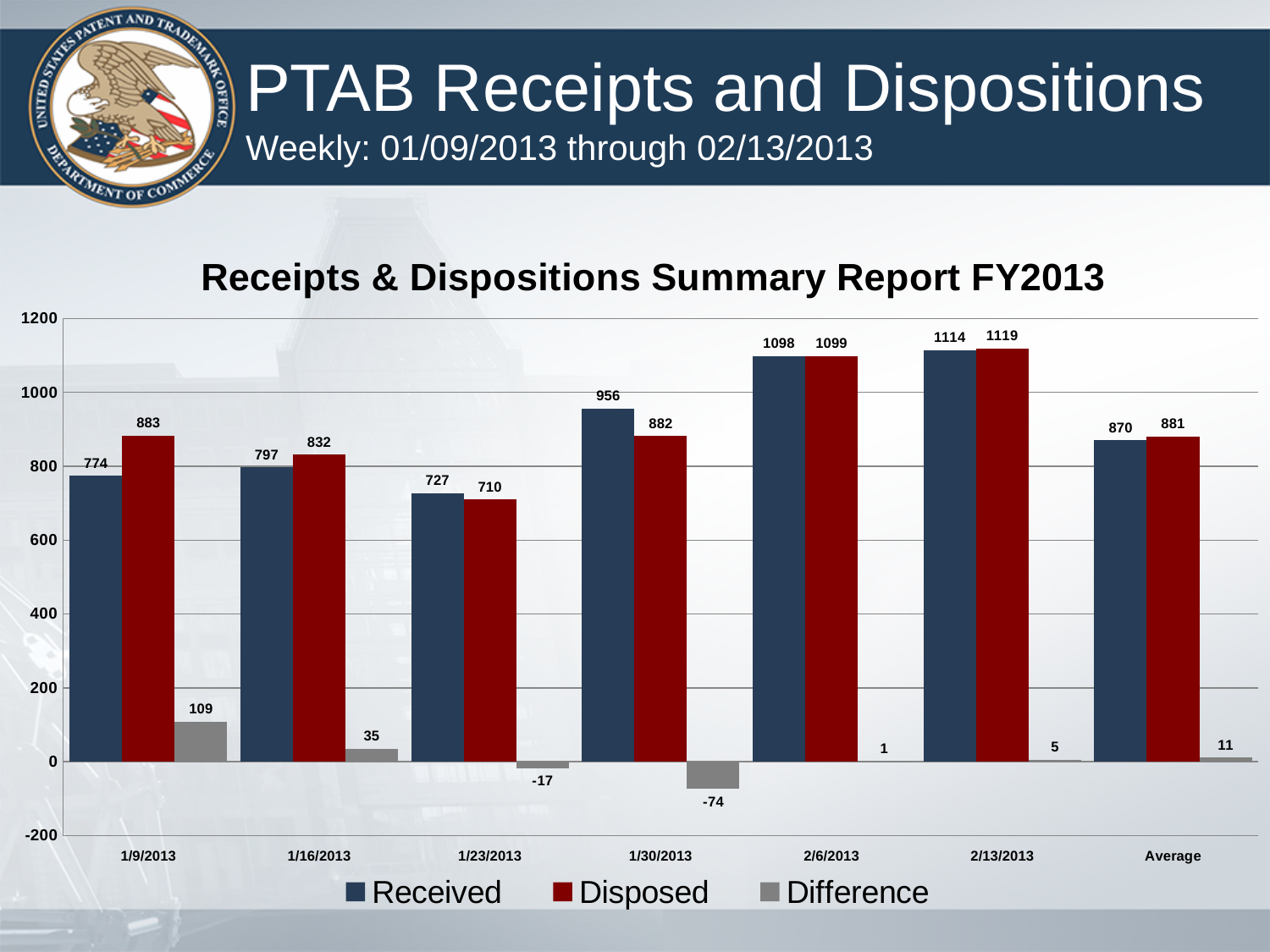
Which date has the lowest Disposed value? 1/23/2013 Is the Received value for 2/6/2013 greater or less than 1000? greater What kind of chart is shown? bar chart What is the title of the chart? Receipts & Dispositions Summary Report FY2013 How many categories are shown on the x axis? 7 What is the difference between the Disposed and Received values for 1/16/2013? 35 Which date has the highest Received value? 2/13/2013 What is the Disposed value for 1/9/2013? 883 How many series does the legend list? 3 What is the Difference value for 1/30/2013? -74 What is the Received value for 1/30/2013? 956 Which is larger for 1/23/2013, Received or Disposed? Received